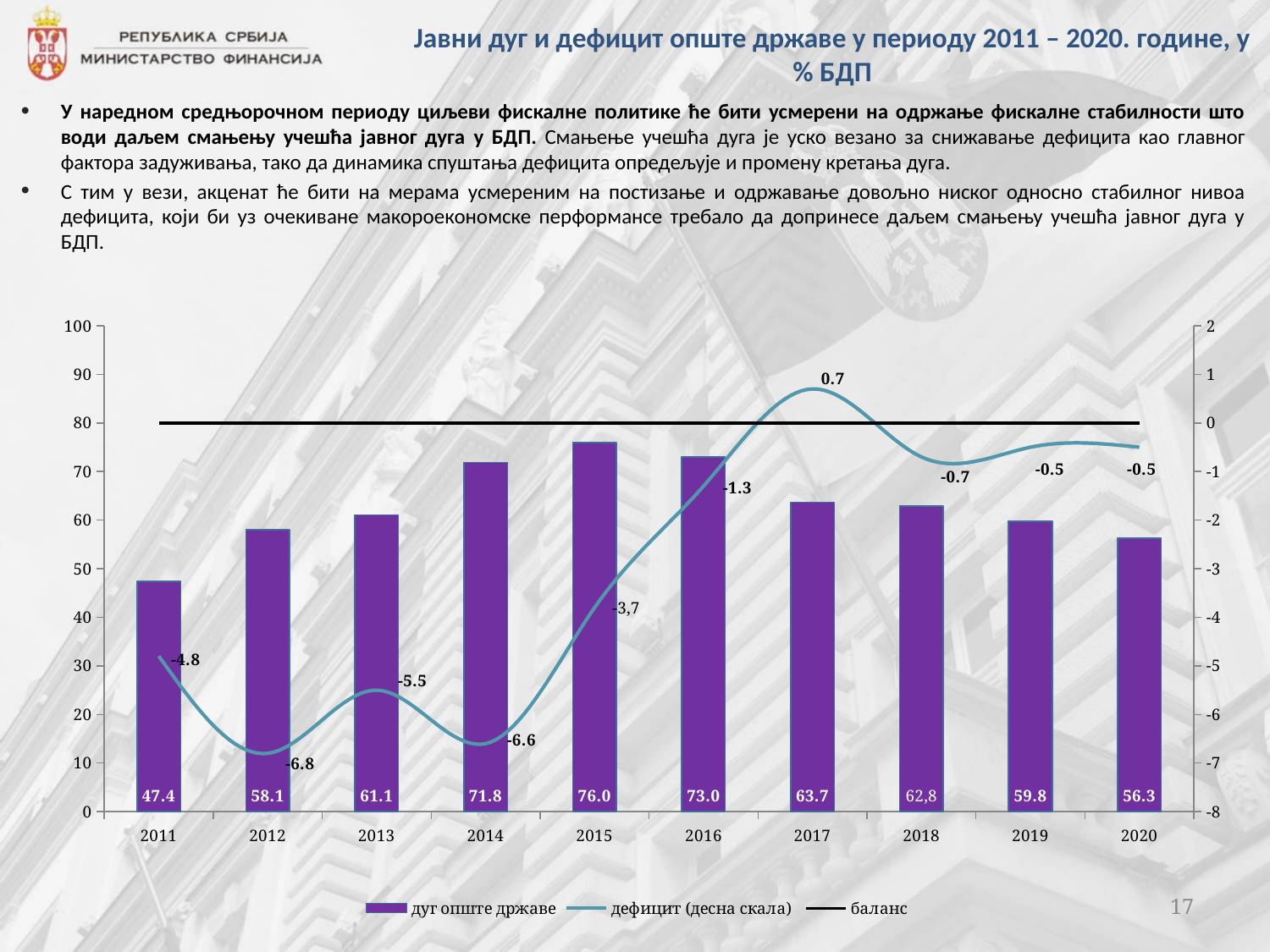
How many years are shown on the x axis of the chart? 10 Which year has the lowest debt bar (дуг опште државе)? 2011 How many series does the chart legend list? 3 What is the deficit (дефицит) value shown for 2017? 0.7 Which series in the legend is drawn as a black horizontal line? баланс What is the deficit (дефицит) value shown for 2012? -6.8 What is the value of the debt bar (дуг опште државе) for 2015? 76.0 Does the debt bar series rise or fall from 2015 to 2020? fall Which year has the highest debt bar (дуг опште државе)? 2015 Is the debt bar for 2016 higher or lower than the debt bar for 2017? higher What is the value of the debt bar (дуг опште државе) for 2011? 47.4 What is the difference between the debt values for 2015 and 2020? 19.7